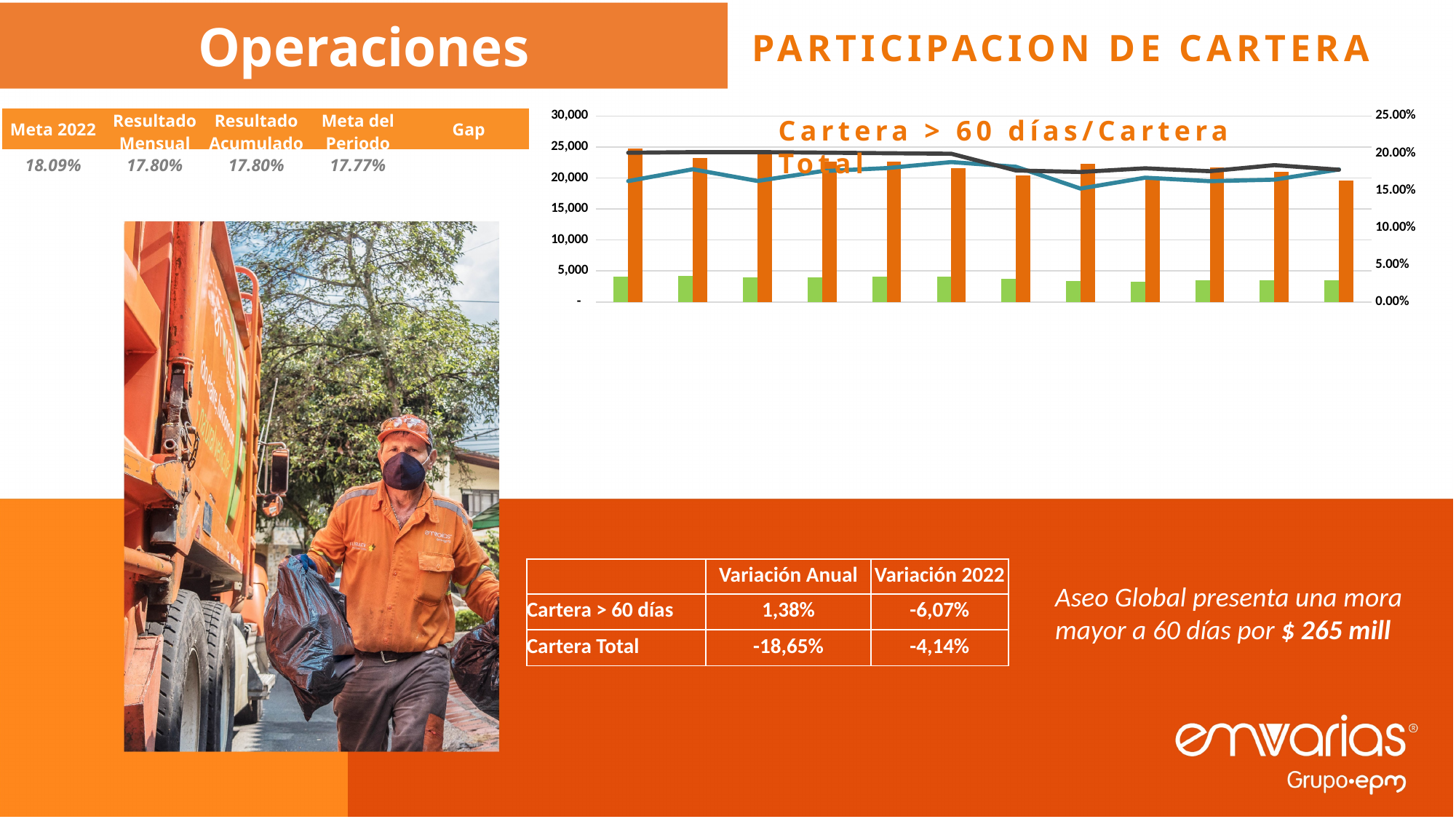
Is the first point of the dark grey line greater or less than 15.00% on the right axis? greater Is the lowest point of the blue line greater or less than 20.00% on the right axis? less Are the green bars greater or less than 5,000? less Which is larger, the first orange bar or the last orange bar? The first orange bar What is the highest value shown on the left vertical axis? 30,000 Does the dark grey line rise or fall overall from left to right? fall What is the title of the chart? Cartera > 60 días/Cartera Total How many orange bars are plotted in the chart? 12 In each group, which bar is taller, the orange bar or the green bar? The orange bar Do the orange bars generally rise or fall from left to right? fall What kind of chart is shown on the slide? A combination bar and line chart